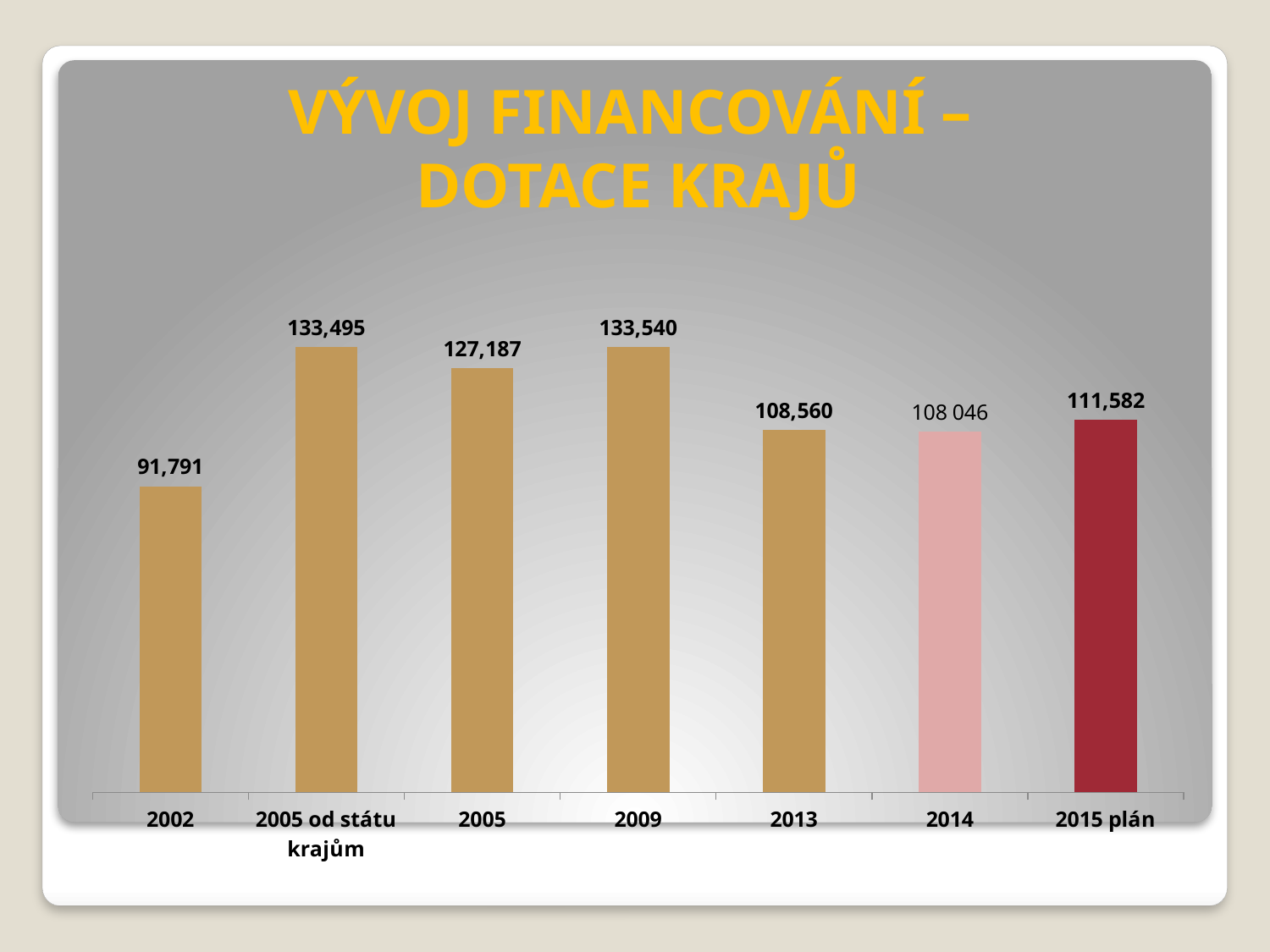
What is the value for 2014? 108 046 What is the value for 2015 plán? 111,582 What is the title of the slide? VÝVOJ FINANCOVÁNÍ – DOTACE KRAJŮ How many categories are shown on the x axis? 7 What kind of chart is shown on the slide? bar chart What is the value for 2005 od státu krajům? 133,495 Which is larger, the value for 2015 plán or the value for 2014? 2015 plán What is the difference between the values for 2005 od státu krajům and 2005? 6,308 What is the value for 2002? 91,791 Which category has the lowest value? 2002 What is the value for 2009? 133,540 What is the difference between the values for 2013 and 2014? 514